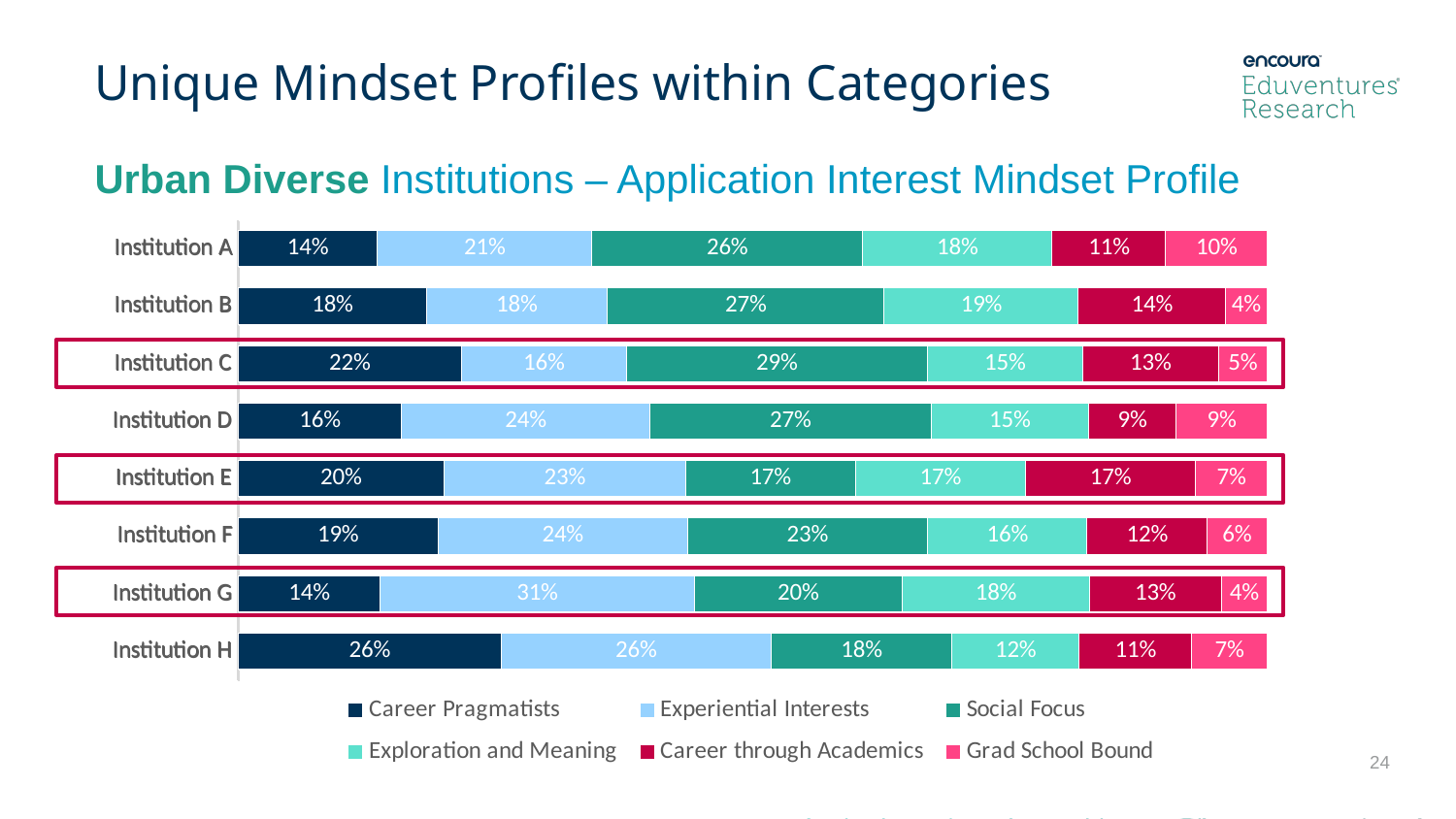
How many institutions are shown in the chart? 8 Which has the larger Experiential Interests value, Institution D or Institution B? Institution D Which institutions are outlined with red boxes on the chart? Institution C, Institution E and Institution G How many series does the legend list? 6 What is the Social Focus value for Institution E? 17% What is the Exploration and Meaning value for Institution B? 19% What is the difference between the Career Pragmatists values for Institution C and Institution A? 8 percentage points What is the Career Pragmatists value for Institution H? 26% Which institution has the highest Social Focus value? Institution C What kind of chart is shown on the slide? Stacked bar chart What is the Experiential Interests value for Institution G? 31% Which institution has the lowest Career through Academics value? Institution D